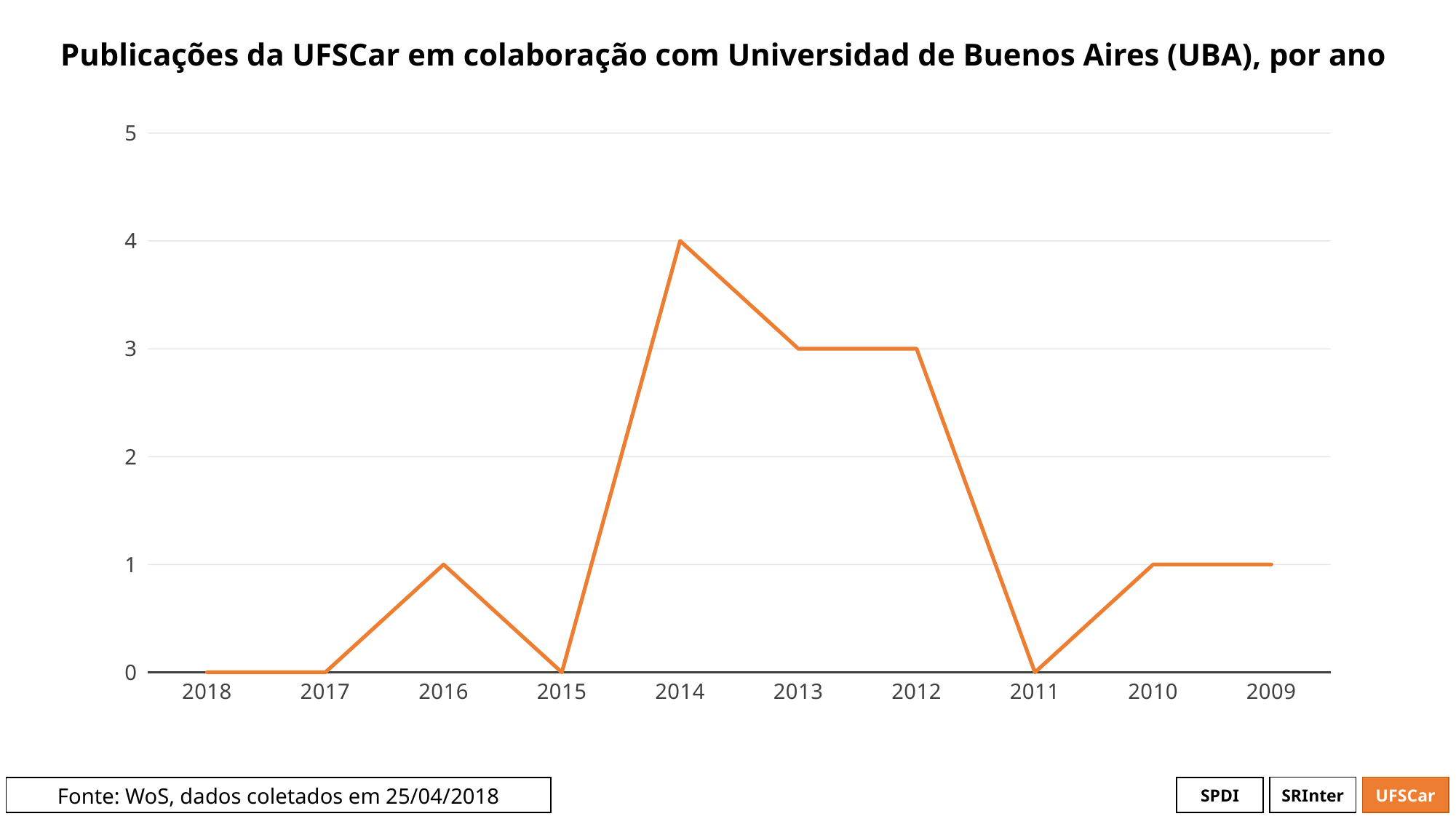
Which is larger, the value for 2010 or the value for 2013? 2013 What is the difference between the values for 2014 and 2012? 1 What is the title of the chart? Publicações da UFSCar em colaboração com Universidad de Buenos Aires (UBA), por ano Is the value for 2014 greater or less than 3? greater What is the value for 2014? 4 Does the line rise or fall from 2014 to 2011 along the x axis? fall What is the value for 2016? 1 Which year has the highest value? 2014 What type of chart is shown on the slide? line chart How many years are plotted along the x axis? 10 What is the value for 2013? 3 What is the value for 2011? 0